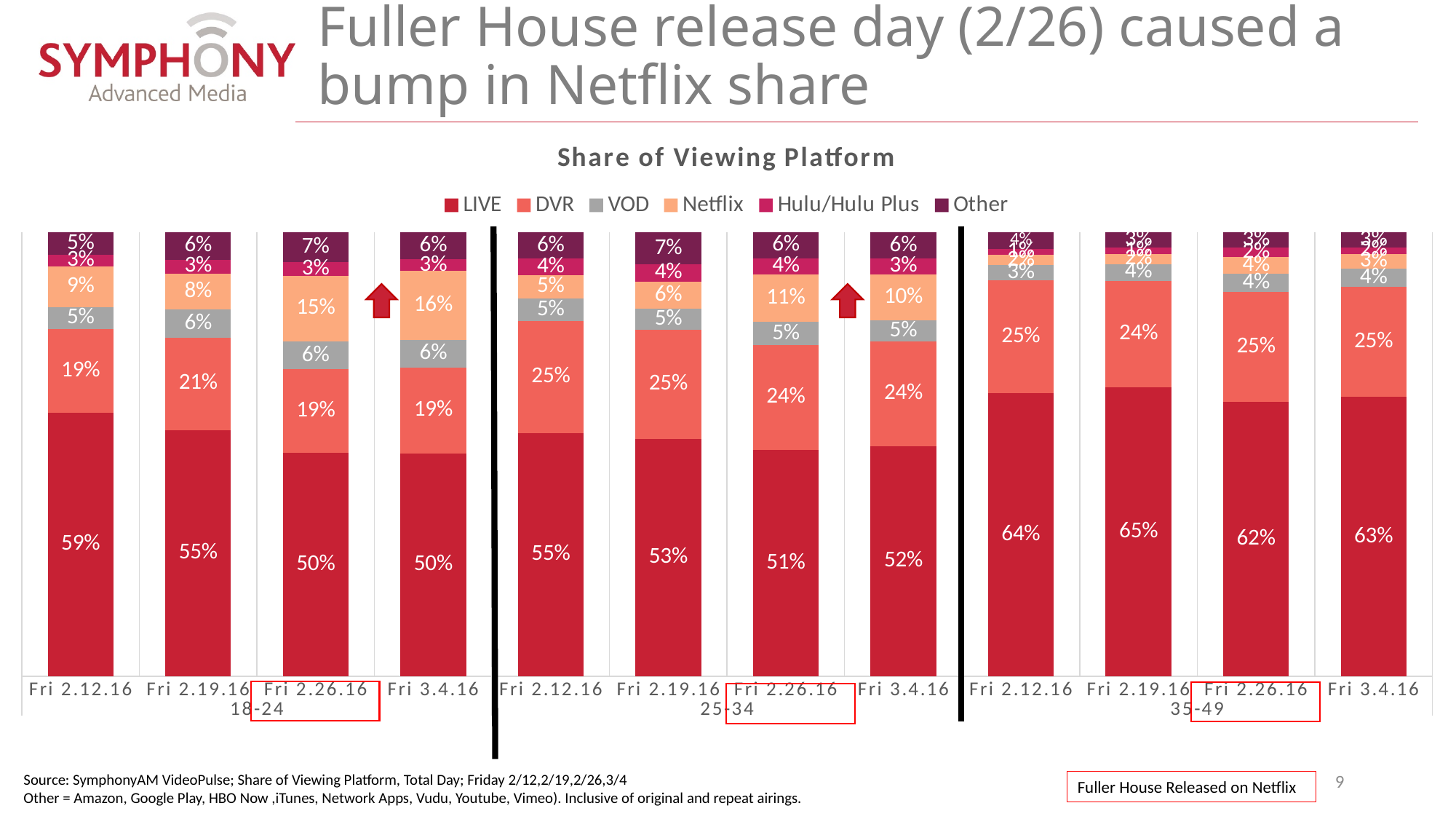
What kind of chart is shown on the slide? Stacked bar chart By how many percentage points did the Netflix share for the 18-24 group change from Fri 2.19.16 to Fri 2.26.16? 7 percentage points What is the Netflix share for the 18-24 group on Fri 2.26.16? 15% What is the DVR share for the 25-34 group on Fri 2.12.16? 25% Within the 25-34 group, on which date is the Netflix share highest? Fri 2.26.16 What is the title of the chart on the slide? Share of Viewing Platform What is the LIVE share for the 35-49 group on Fri 2.19.16? 65% How does the LIVE share for the 18-24 group change from Fri 2.12.16 to Fri 3.4.16? It falls How many bars are plotted in the Share of Viewing Platform chart? 12 Which is larger for the 25-34 group on Fri 2.26.16: the Netflix share or the VOD share? Netflix share Within the 18-24 group, on which date is the LIVE share highest? Fri 2.12.16 How many series does the legend of the Share of Viewing Platform chart list? 6